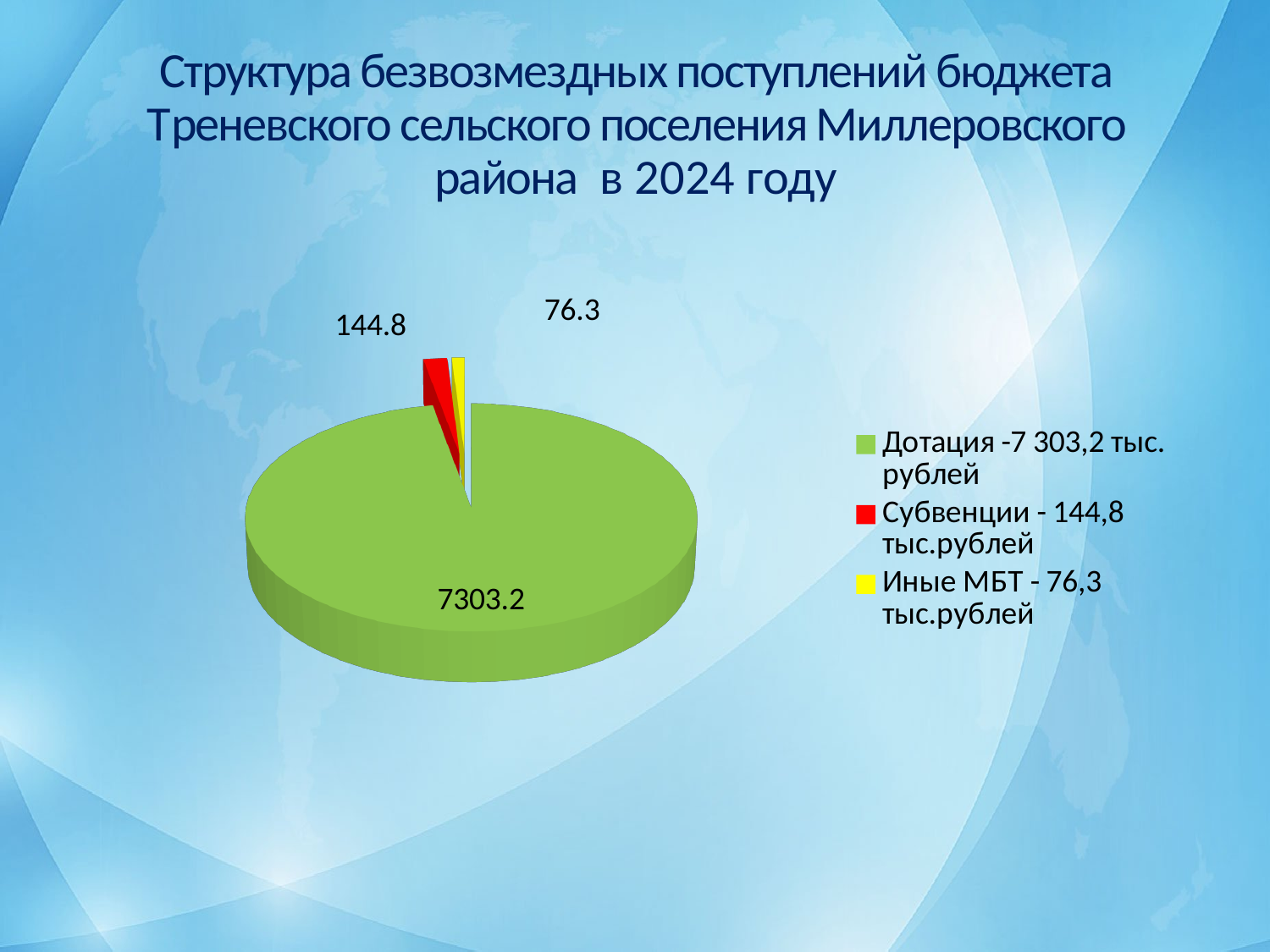
What colour is the Субвенции slice in the pie chart? Red What is the difference between the Субвенции value and the Иные МБТ value? 68.5 What is the difference between the Дотация value and the Субвенции value? 7158.4 How many slices does the pie chart have? 3 What is the value shown for the Дотация slice? 7303.2 Which category has the largest slice of the pie? Дотация What is the value shown for the Субвенции slice? 144.8 What is the value shown for the Иные МБТ slice? 76.3 How many entries does the legend list? 3 Which is larger, Субвенции or Иные МБТ? Субвенции Which category has the smallest slice of the pie? Иные МБТ What kind of chart is shown on the slide? Pie chart